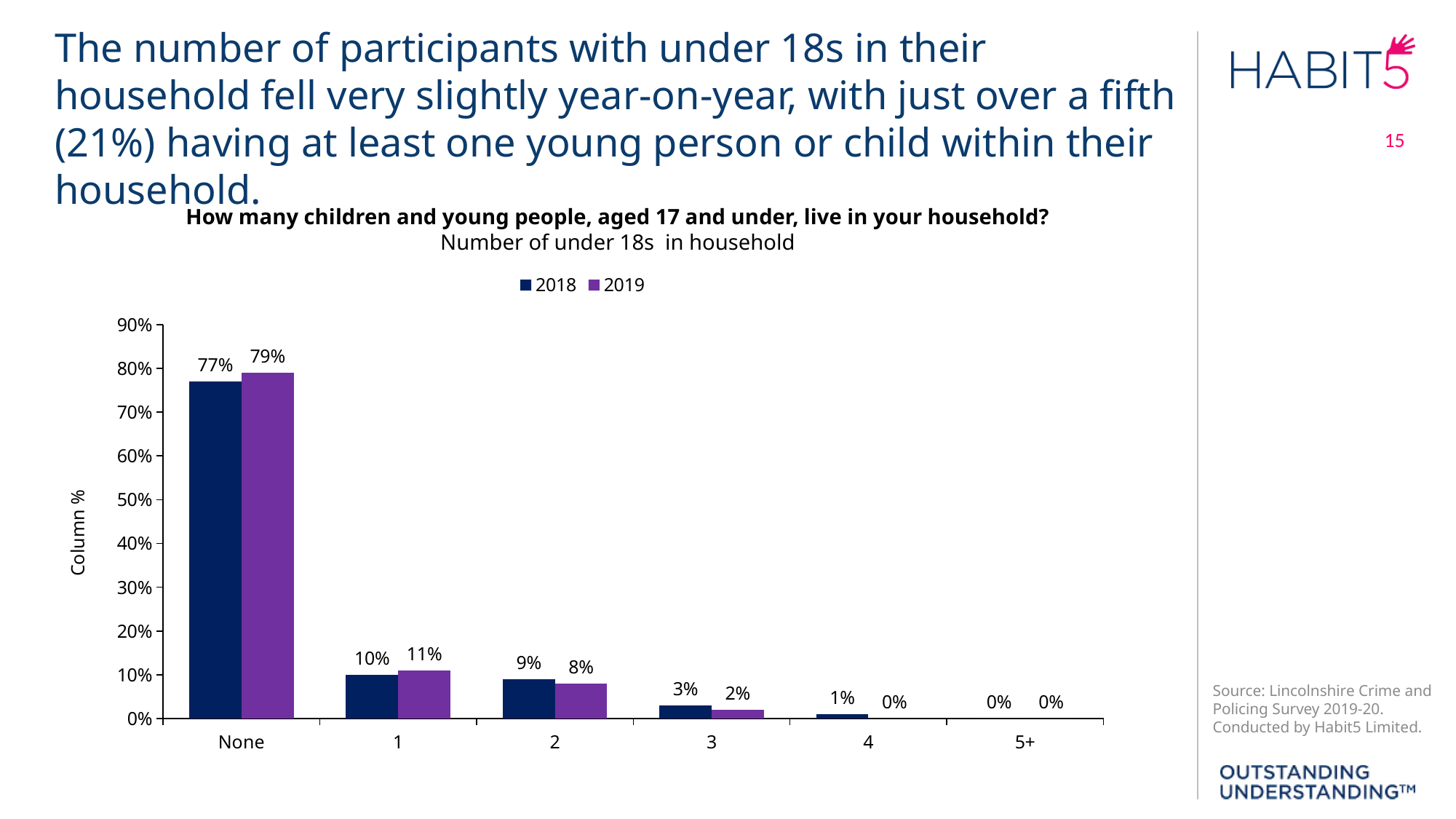
What is the 2018 value for the '1' category? 10% What is the difference between the 2018 and 2019 values for the '2' category? 1% What is the 2018 value for the '3' category? 3% What is the 2019 value for the '2' category? 8% How many categories are shown on the x axis? 6 What kind of chart is shown on the slide? Bar chart Which category has the highest value for 2018? None What is the 2019 value for the 'None' category? 79% What is the label of the y axis? Column % What is the difference between the 2019 and 2018 values for the 'None' category? 2% For the '1' category, which year has the larger value, 2018 or 2019? 2019 How many series does the legend list? 2